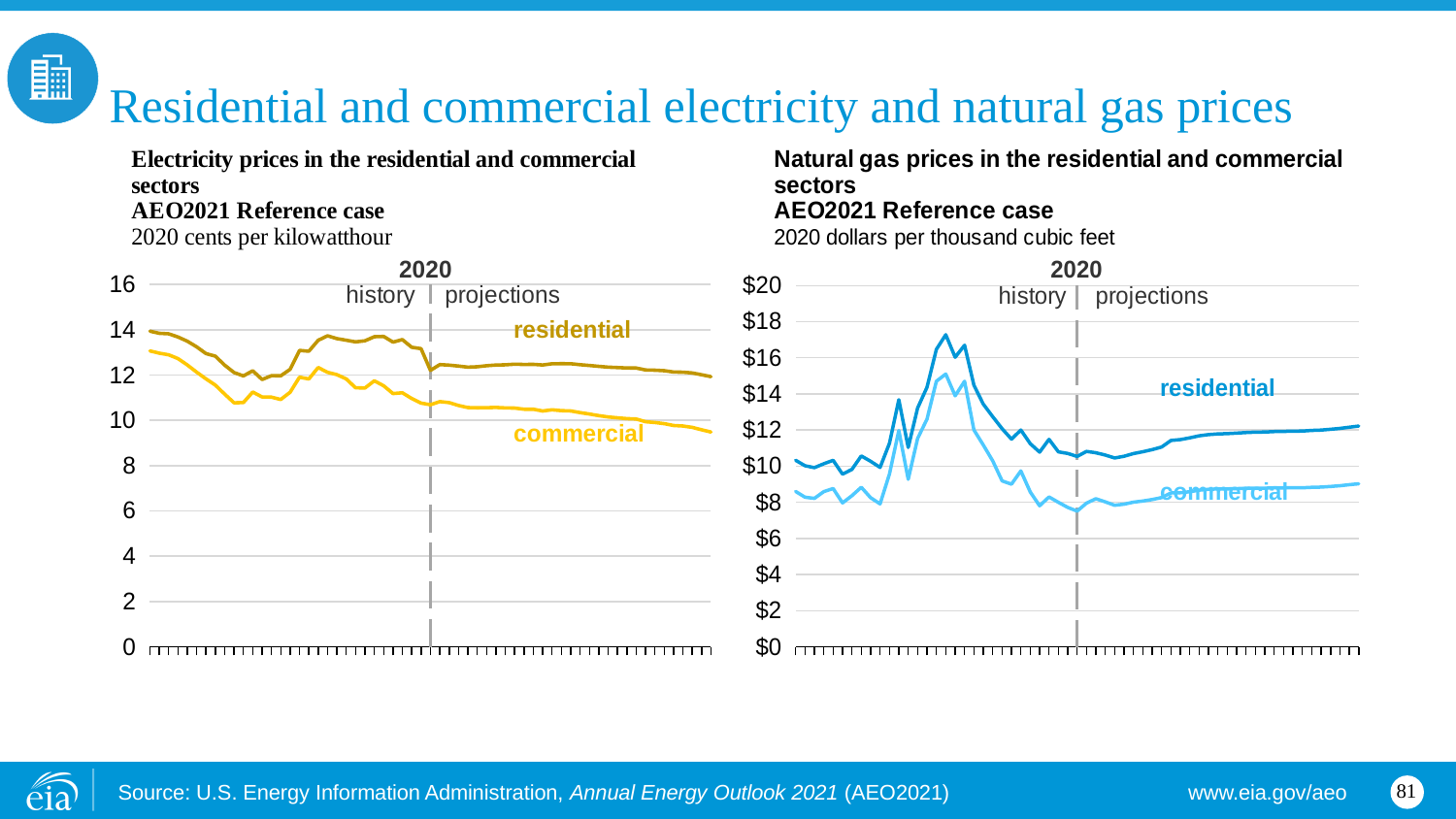
On the 'Electricity prices in the residential and commercial sectors' chart, does the commercial series rise or fall over the projection period? fall What year separates history from projections on both charts? 2020 What kind of chart is the 'Electricity prices in the residential and commercial sectors' chart? line chart On the 'Natural gas prices in the residential and commercial sectors' chart, is the commercial value at the end of the projection period greater or less than $10? less How many series are plotted on the 'Natural gas prices in the residential and commercial sectors' chart? 2 On the 'Natural gas prices in the residential and commercial sectors' chart, which series is higher at the end of the projection period, residential or commercial? residential On the 'Natural gas prices in the residential and commercial sectors' chart, is the peak residential value greater or less than $16? greater What unit is used on the 'Natural gas prices in the residential and commercial sectors' chart? 2020 dollars per thousand cubic feet On the 'Electricity prices in the residential and commercial sectors' chart, which series is higher throughout, residential or commercial? residential On the 'Natural gas prices in the residential and commercial sectors' chart, does the residential series rise or fall over the projection period? rise On the 'Electricity prices in the residential and commercial sectors' chart, is the commercial value at the end of the projection period greater or less than 10? less